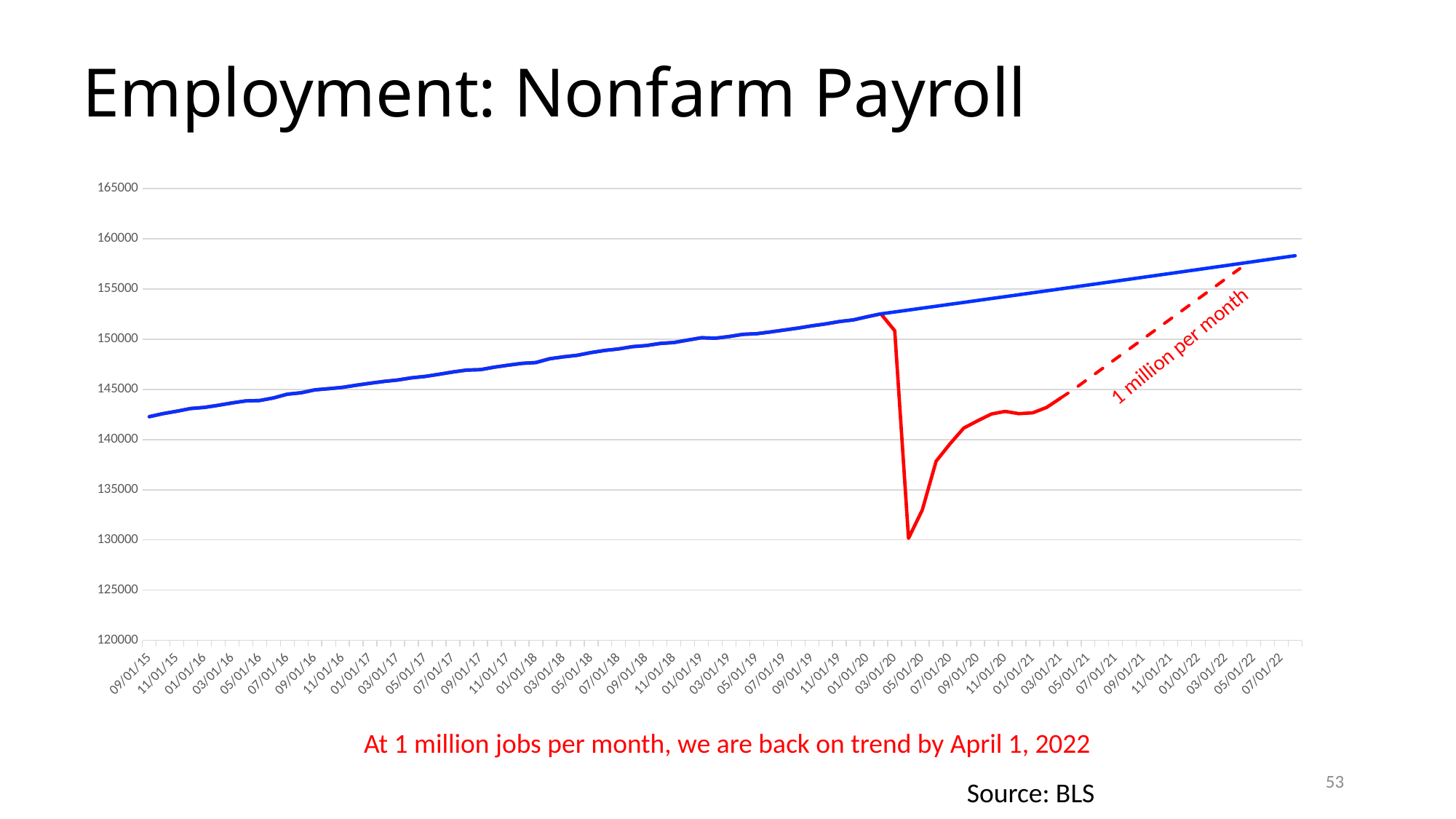
What is the title of the slide containing the chart? Employment: Nonfarm Payroll Does the blue line rise or fall from 09/01/15 to 07/01/22? rise Does the red line rise or fall between 03/01/20 and 05/01/20? fall Is the value of the blue line at 01/01/18 greater or less than 145000? greater What kind of chart is shown on the slide? line chart Is the lowest point of the red line greater or less than 135000? less Which line is higher at 07/01/20, the blue line or the red line? the blue line Is the value of the blue line at 07/01/22 greater or less than 155000? greater What does the red annotation along the dashed line say? 1 million per month